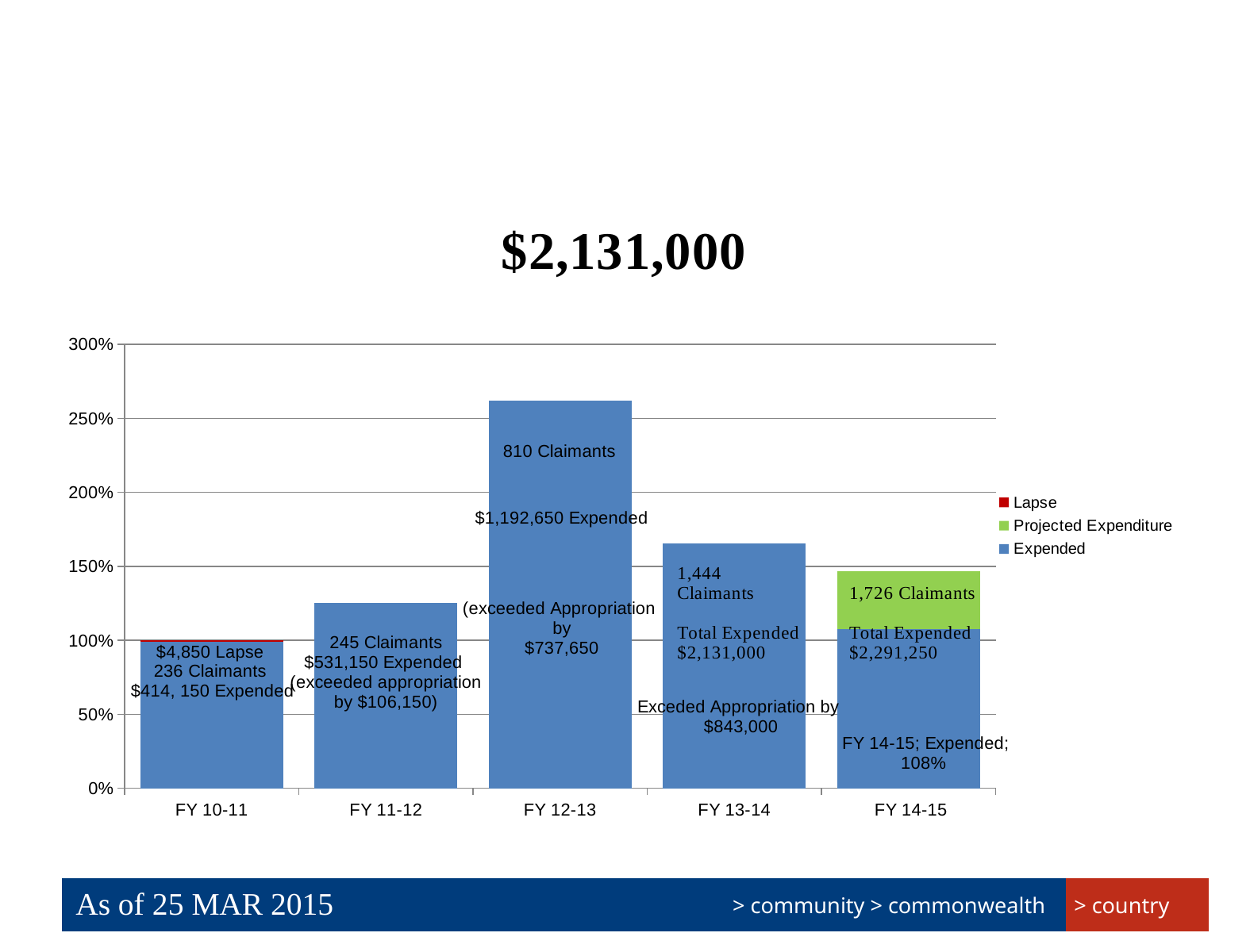
Is the bar for FY 13-14 greater or less than 150%? greater Which fiscal year has the tallest bar? FY 12-13 What are the three legend entries of the chart? Lapse, Projected Expenditure, Expended Is the bar for FY 11-12 greater or less than 100%? greater Is the bar for FY 12-13 greater or less than 250%? greater What kind of chart is shown on the slide? bar chart Which bar is taller, FY 13-14 or FY 11-12? FY 13-14 Which fiscal year has the shortest bar? FY 10-11 What Expended percentage is printed for FY 14-15? 108% How many claimants are labelled on the FY 12-13 bar? 810 Claimants How many fiscal year categories are shown on the x axis? 5 How many series does the legend list? 3